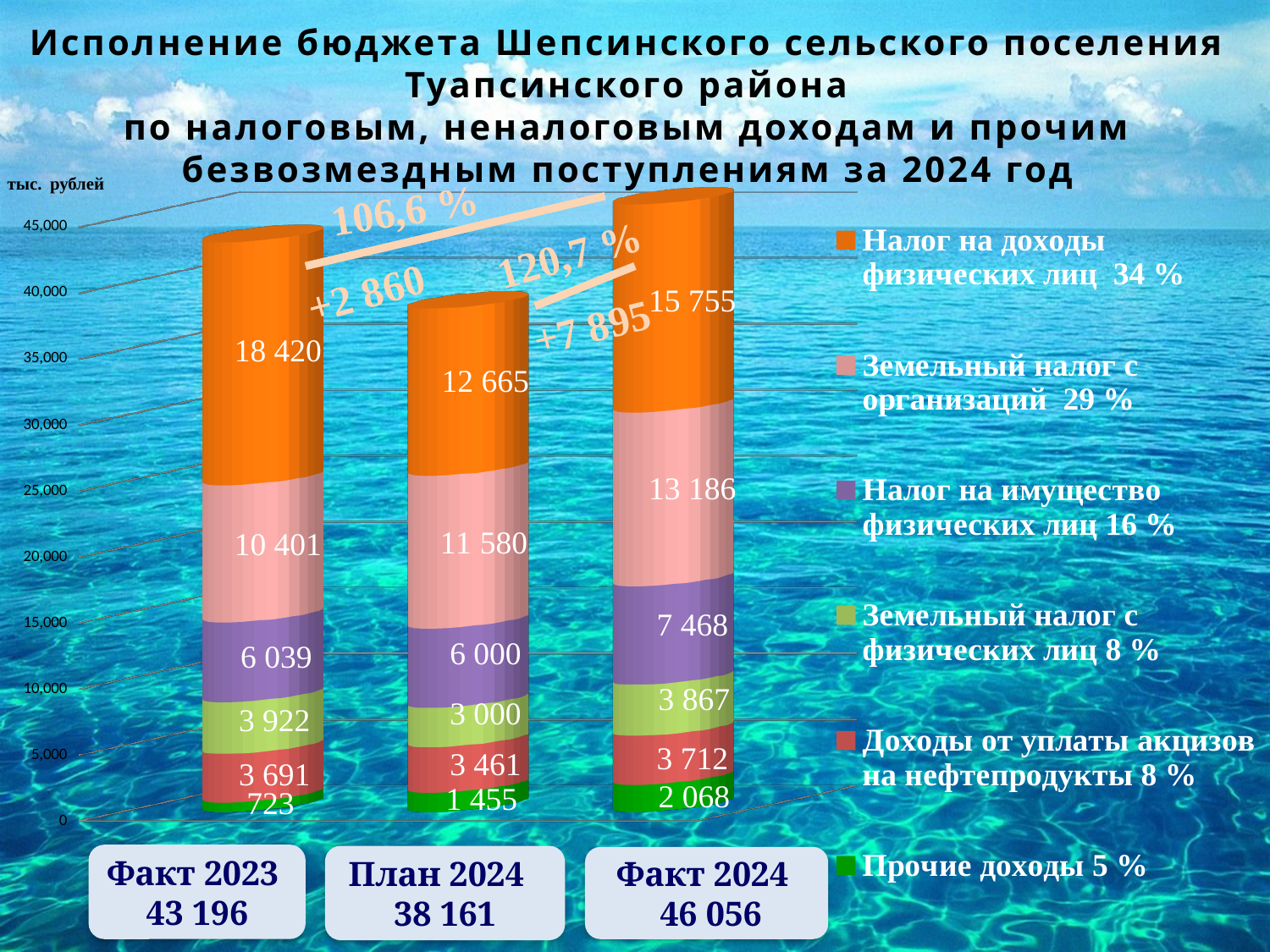
Which bar has the lowest total? План 2024 Which bar has the highest total? Факт 2024 What is the total of the Факт 2024 bar? 46 056 What is the value of Прочие доходы for Факт 2024? 2 068 How many bars (categories) are plotted on the chart? 3 What is the difference between Налог на имущество физических лиц for Факт 2024 and for План 2024? 1 468 How many series does the legend list? 6 What type of chart is shown on the slide? stacked bar chart What is the value of Земельный налог с организаций for План 2024? 11 580 What is the value of Налог на доходы физических лиц for Факт 2023? 18 420 What share of the total does Налог на доходы физических лиц have according to the legend? 34 % Which is larger: Земельный налог с физических лиц for Факт 2023 or for Факт 2024? Факт 2023